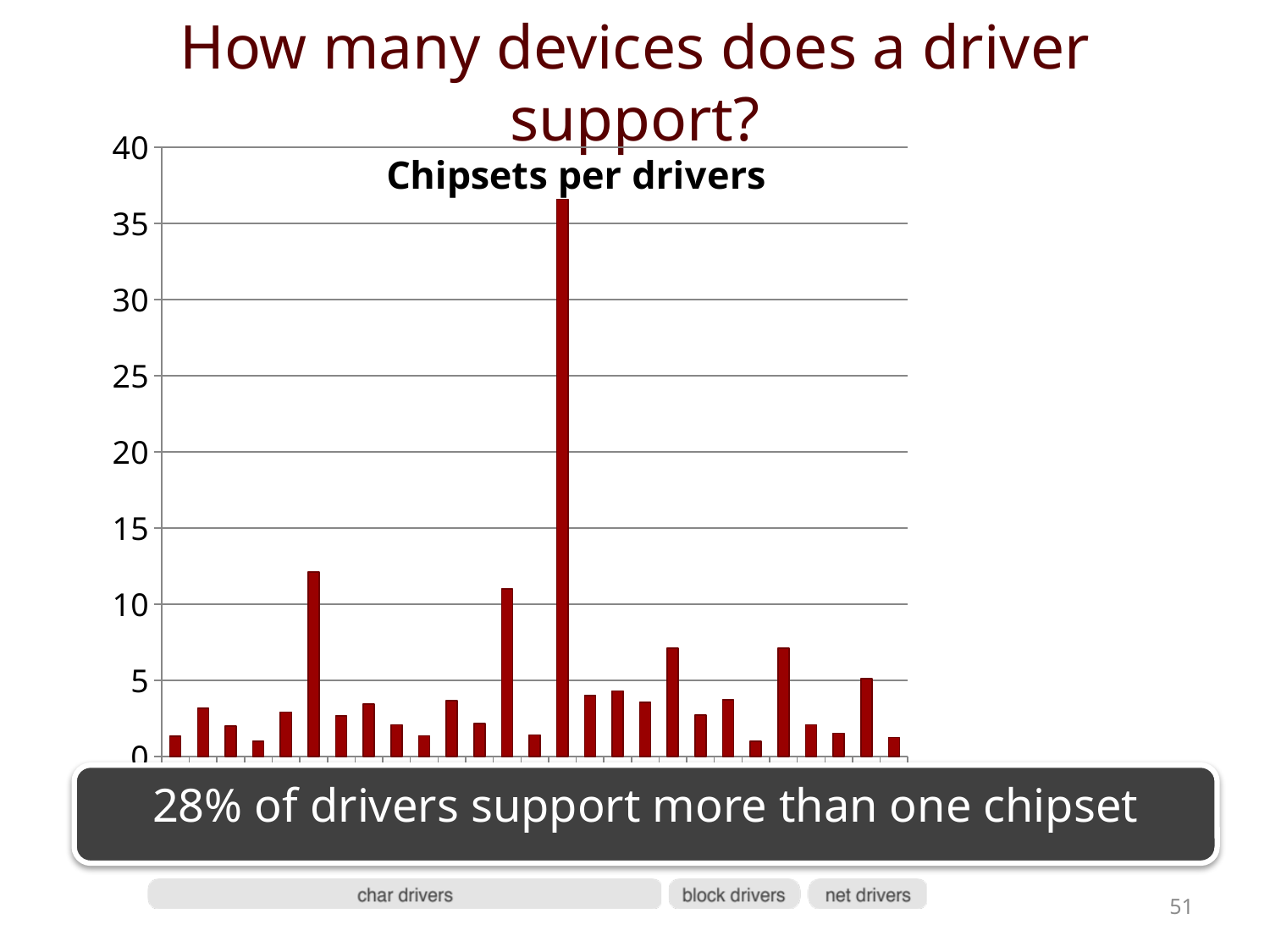
What is the title of the chart? Chipsets per drivers What is the highest value shown on the vertical axis of the chart? 40 What kind of chart is shown on the slide? bar chart How many bars are plotted in the chart? 27 Is the value of the second-tallest bar in the chart greater or less than 10? greater How many bars in the chart have a value greater than 20? 1 How many bars in the chart have a value greater than 10? 3 Is the value of the first (leftmost) bar in the chart greater or less than 5? less Which is larger: the tallest bar in the chart or the second-tallest bar? the tallest bar Is the value of the tallest bar in the chart greater or less than 35? greater